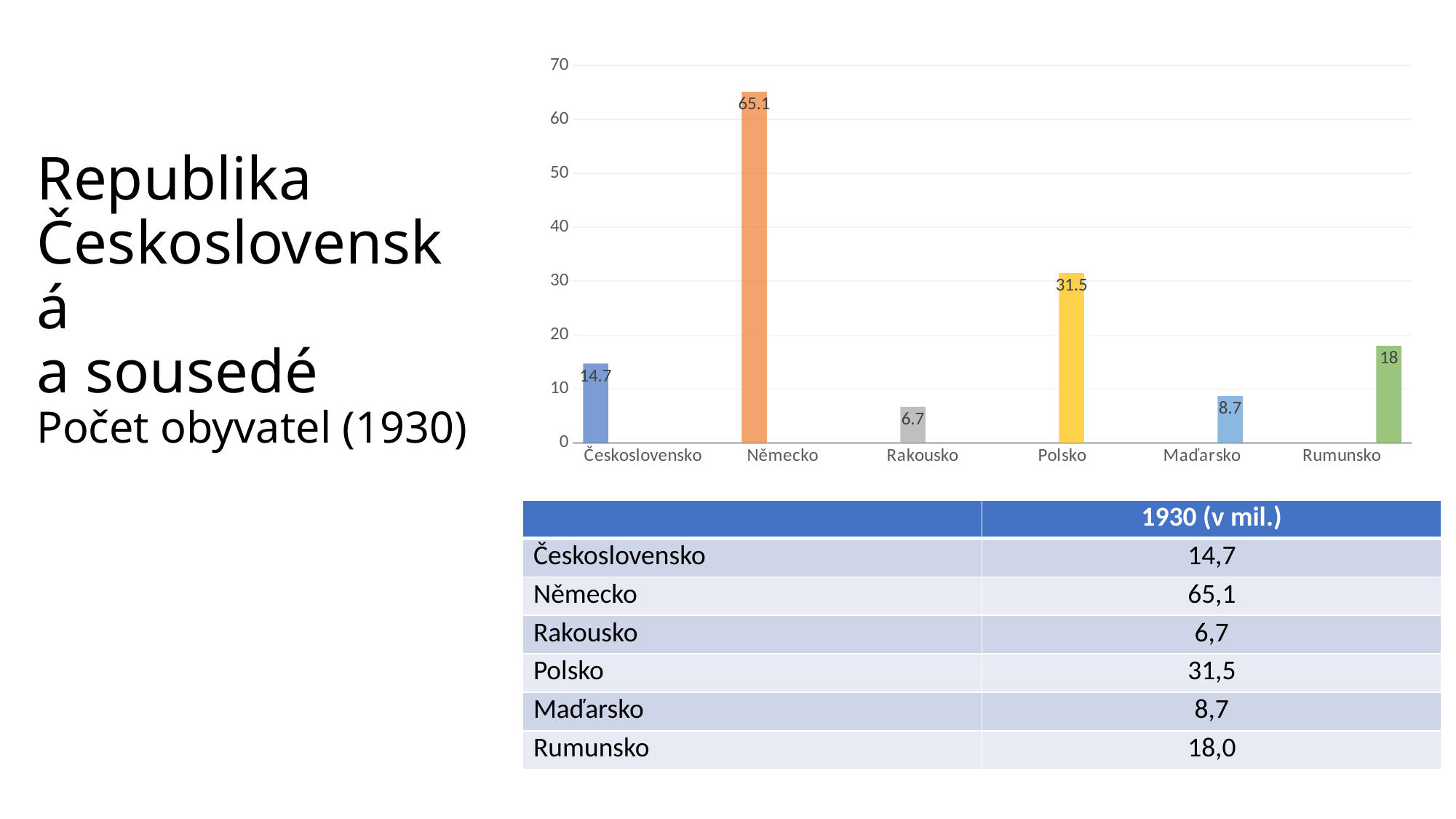
What is the difference between the values for Československo and Maďarsko? 6 What is the value shown for Československo in the chart? 14.7 How many categories are plotted in the chart? 6 What type of chart is shown on the slide? bar chart What is the value shown for Německo in the chart? 65.1 Which category has the highest value in the chart? Německo What is the highest value shown on the vertical axis of the chart? 70 What is the difference between the values for Německo and Polsko? 33.6 Which has a larger value, Maďarsko or Rumunsko? Rumunsko Which category has the lowest value in the chart? Rakousko What is the value shown for Polsko in the chart? 31.5 What is the value shown for Rumunsko in the chart? 18